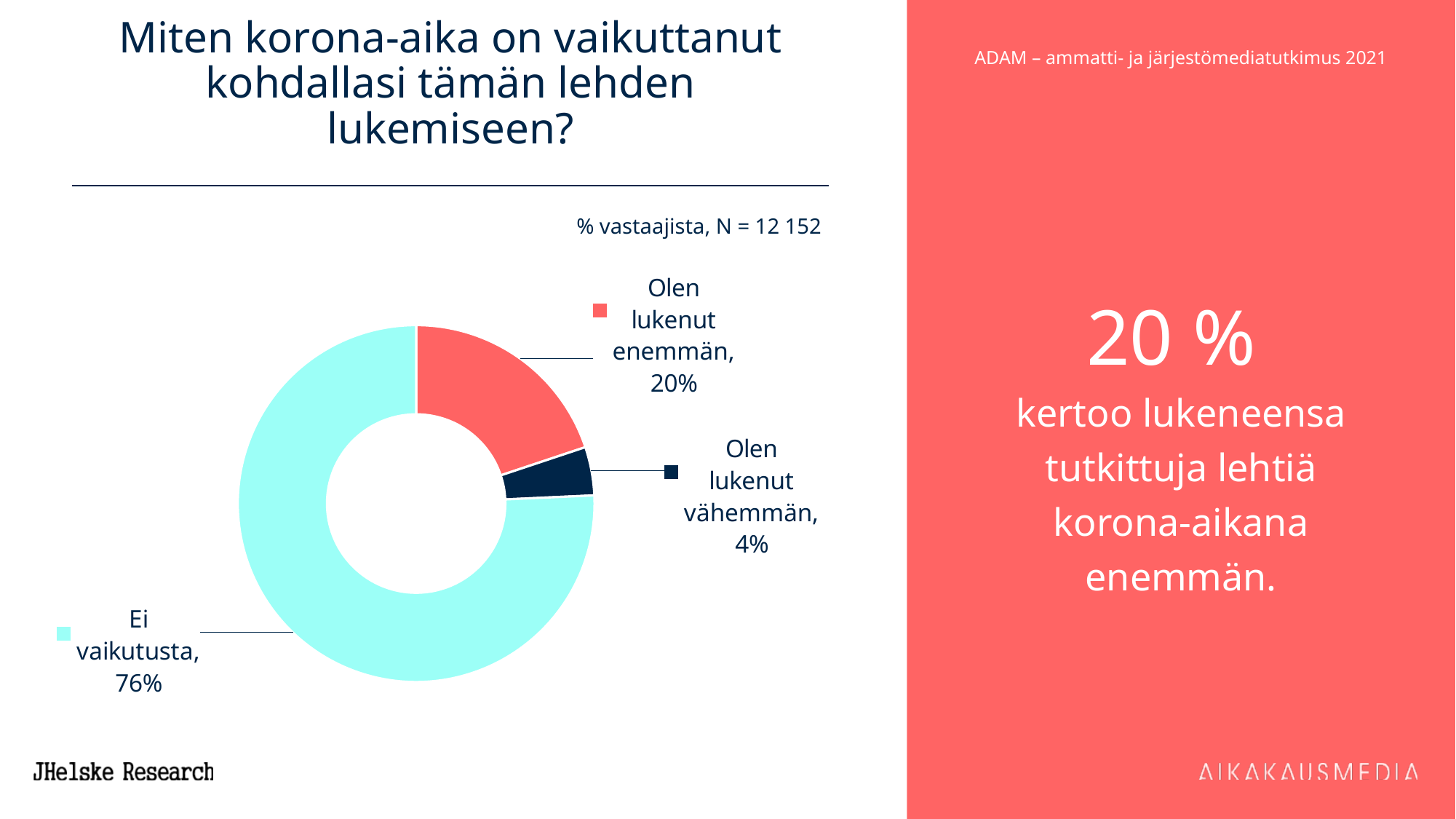
How many categories are shown in the chart? 3 What kind of chart is shown on the slide? Pie chart (doughnut) What percentage of respondents answered "Olen lukenut vähemmän"? 4% What colour is the "Ei vaikutusta" slice? Light blue (cyan) What is the sample size (N) stated above the chart? 12 152 Which is larger: the share for "Olen lukenut enemmän" or for "Olen lukenut vähemmän"? Olen lukenut enemmän Which category has the smallest share of the pie? Olen lukenut vähemmän What is the difference in percentage points between "Ei vaikutusta" and "Olen lukenut enemmän"? 56 What percentage of respondents answered "Ei vaikutusta"? 76% Which category has the largest share of the pie? Ei vaikutusta What is the difference in percentage points between "Olen lukenut enemmän" and "Olen lukenut vähemmän"? 16 What percentage of respondents answered "Olen lukenut enemmän"? 20%